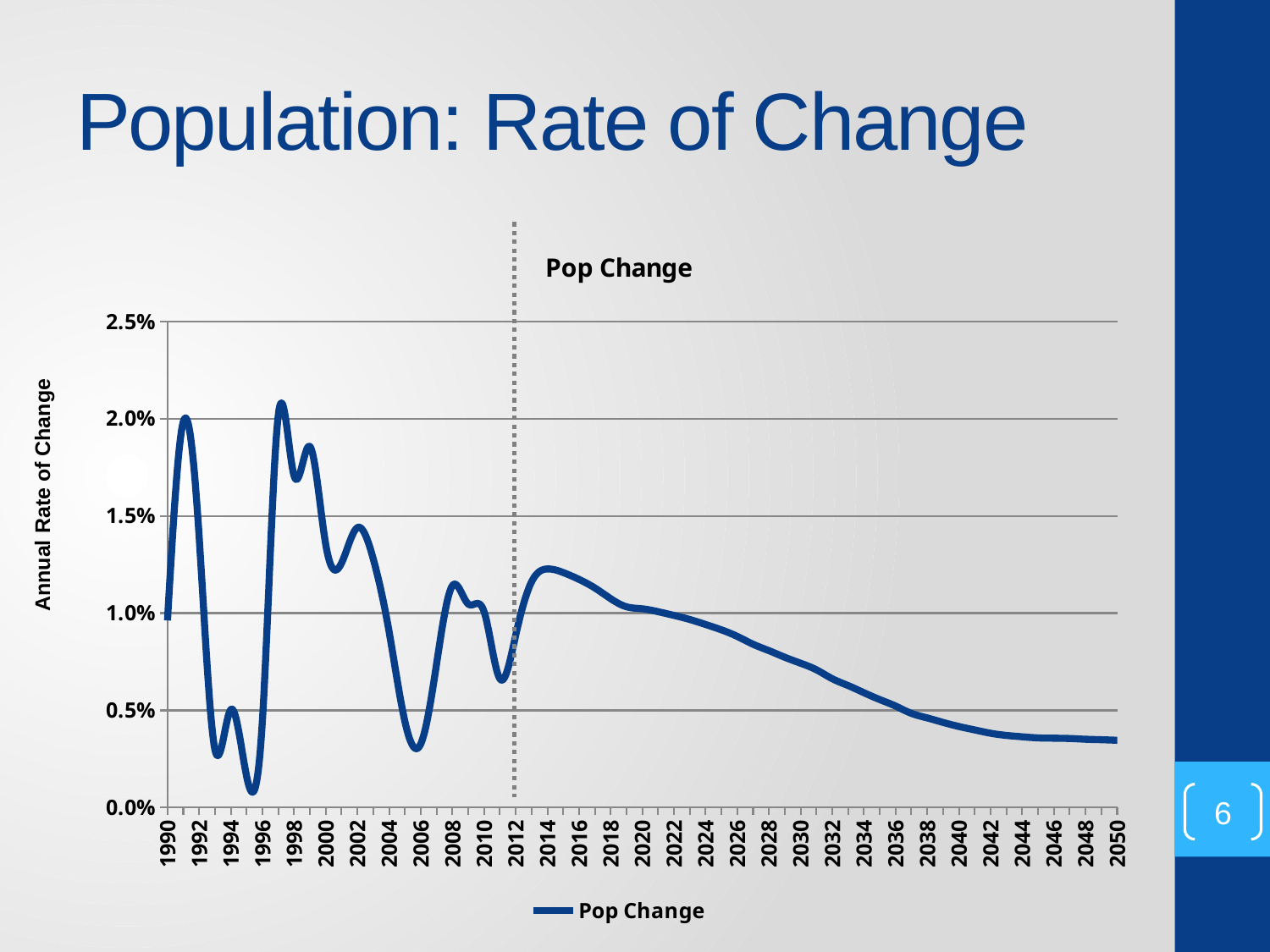
What kind of chart is shown on the slide? line chart Is the value for 2050 greater or less than 0.5%? less Which year has the larger value, 2014 or 2030? 2014 Is the value for 2014 greater or less than 1.0%? greater How many series does the legend list? 1 Is the value for 1995 greater or less than 0.5%? less In which year does the Pop Change line reach its lowest value? 1995 What is the label on the vertical axis of the chart? Annual Rate of Change From 2014 to 2050, does the Pop Change line rise or fall? fall What is the title of the chart? Pop Change